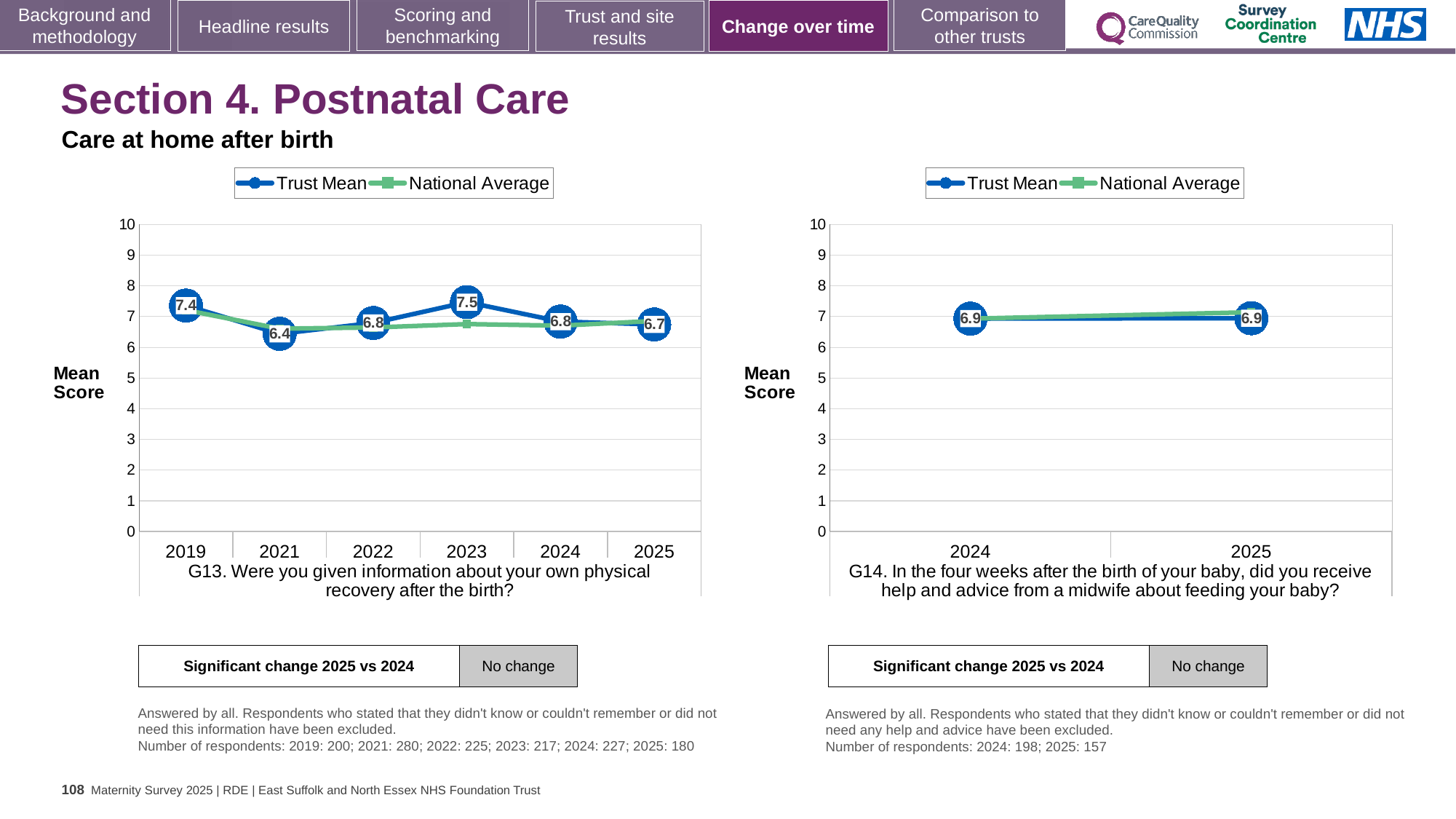
In the G13 chart on the left, what is the Trust Mean score for 2021? 6.4 In the G13 chart on the left, what is the Trust Mean score for 2023? 7.5 In the G13 chart on the left, is the Trust Mean score higher in 2019 or in 2025? 2019 In the G13 chart on the left, does the Trust Mean score rise or fall from 2024 to 2025? Fall How many series does the legend of the G14 chart on the right list? 2 In the G13 chart on the left, what is the difference between the Trust Mean scores for 2023 and 2021? 1.1 In the G13 chart on the left, is the National Average for 2019 greater or less than 8? less What type of chart is the G14 chart on the right? Line chart In the G14 chart on the right, what is the Trust Mean score for 2025? 6.9 In the G13 chart on the left, which year has the highest Trust Mean score? 2023 How many years are plotted on the x axis of the G13 chart on the left? 6 In the G13 chart on the left, which year has the lowest Trust Mean score? 2021